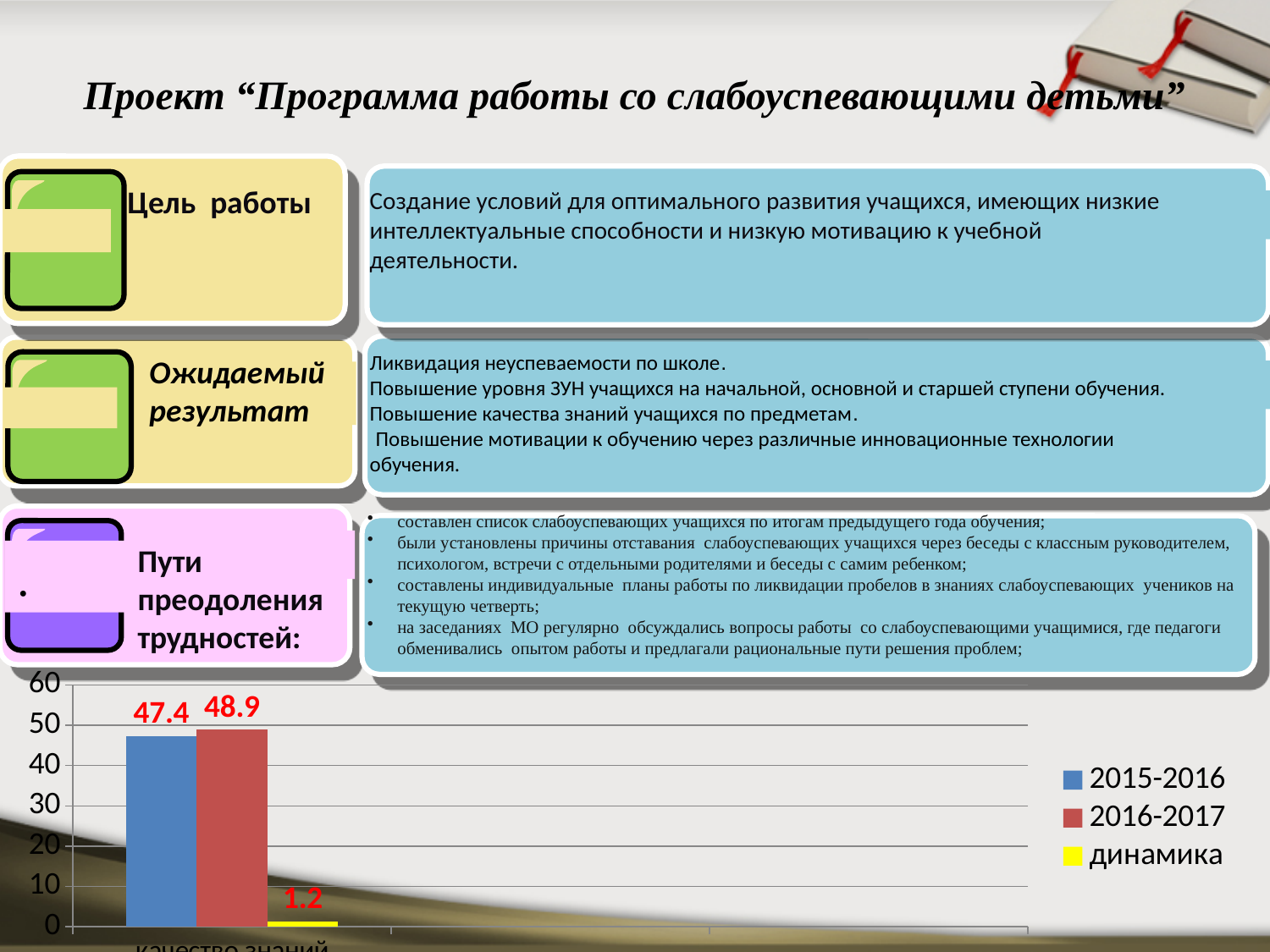
Which series has the lowest value in the chart? динамика Which is larger, the 2015-2016 value or the 2016-2017 value? 2016-2017 How many series does the legend list? 3 What kind of chart is shown on the slide? bar chart What is the difference between the 2016-2017 value and the 2015-2016 value? 1.5 Which series has the highest value in the chart? 2016-2017 What is the value for the динамика series in the chart? 1.2 What is the value for the 2016-2017 series in the chart? 48.9 How many categories are shown on the x axis of the chart? 1 What colour represents the динамика series in the chart? yellow Is the value for 2015-2016 greater or less than 40? greater What is the value for the 2015-2016 series in the chart? 47.4